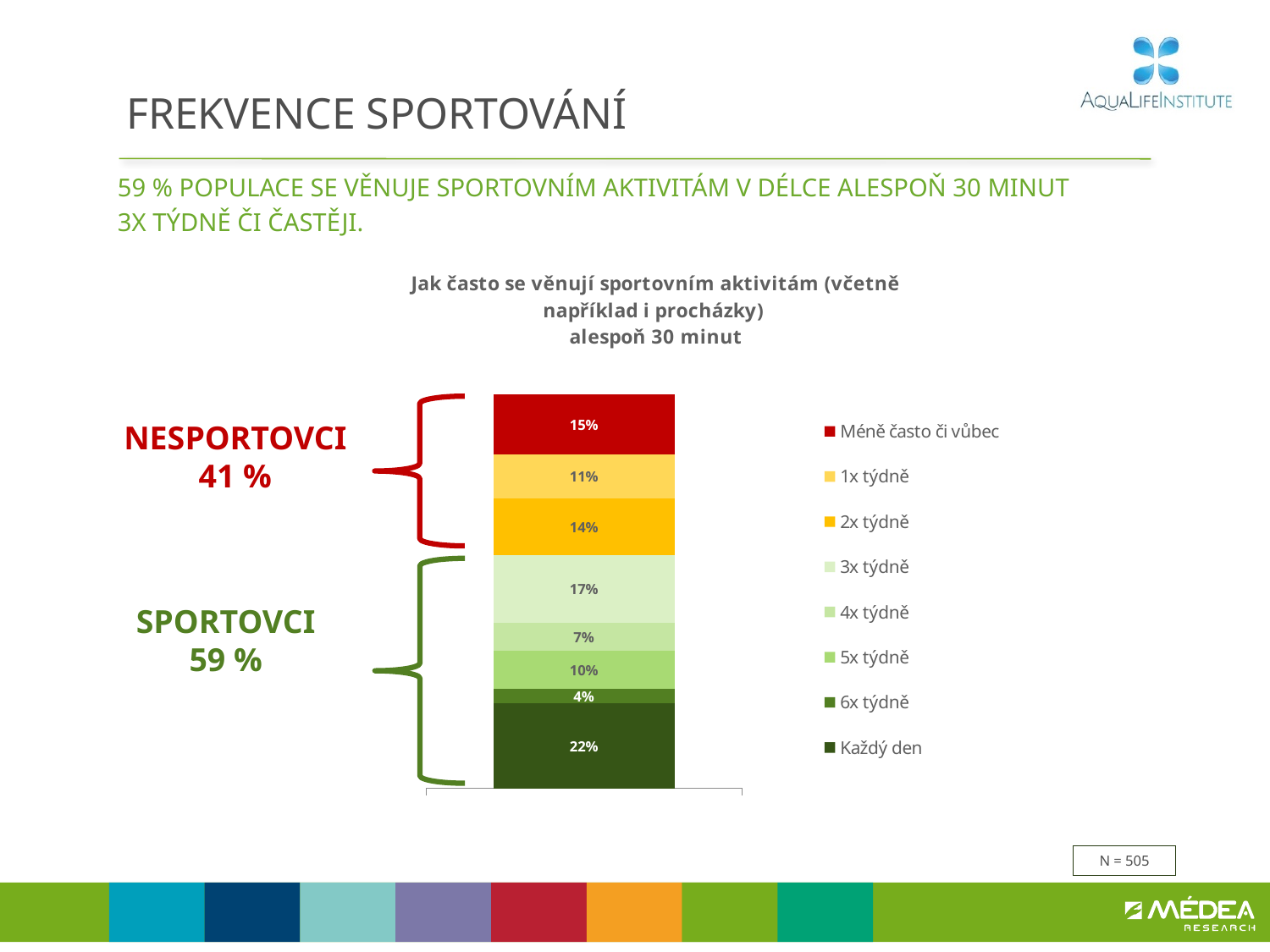
What kind of chart is shown on the slide? Stacked bar chart What is the total of the three segments grouped as NESPORTOVCI (Méně často či vůbec, 1x týdně, 2x týdně)? 40% Which frequency category has the smallest share in the stacked bar? 6x týdně What percentage of respondents do sport activities every day (Každý den)? 22% What is the value for the '6x týdně' segment? 4% Which is larger, the value for '5x týdně' or the value for '4x týdně'? 5x týdně Which frequency category has the largest share in the stacked bar? Každý den What is the value for the '3x týdně' segment? 17% What colour is the 'Méně často či vůbec' segment in the chart? Red What is the value for the 'Méně často či vůbec' segment? 15% How many series does the legend list? 8 What is the difference between the '2x týdně' and '1x týdně' values? 3%